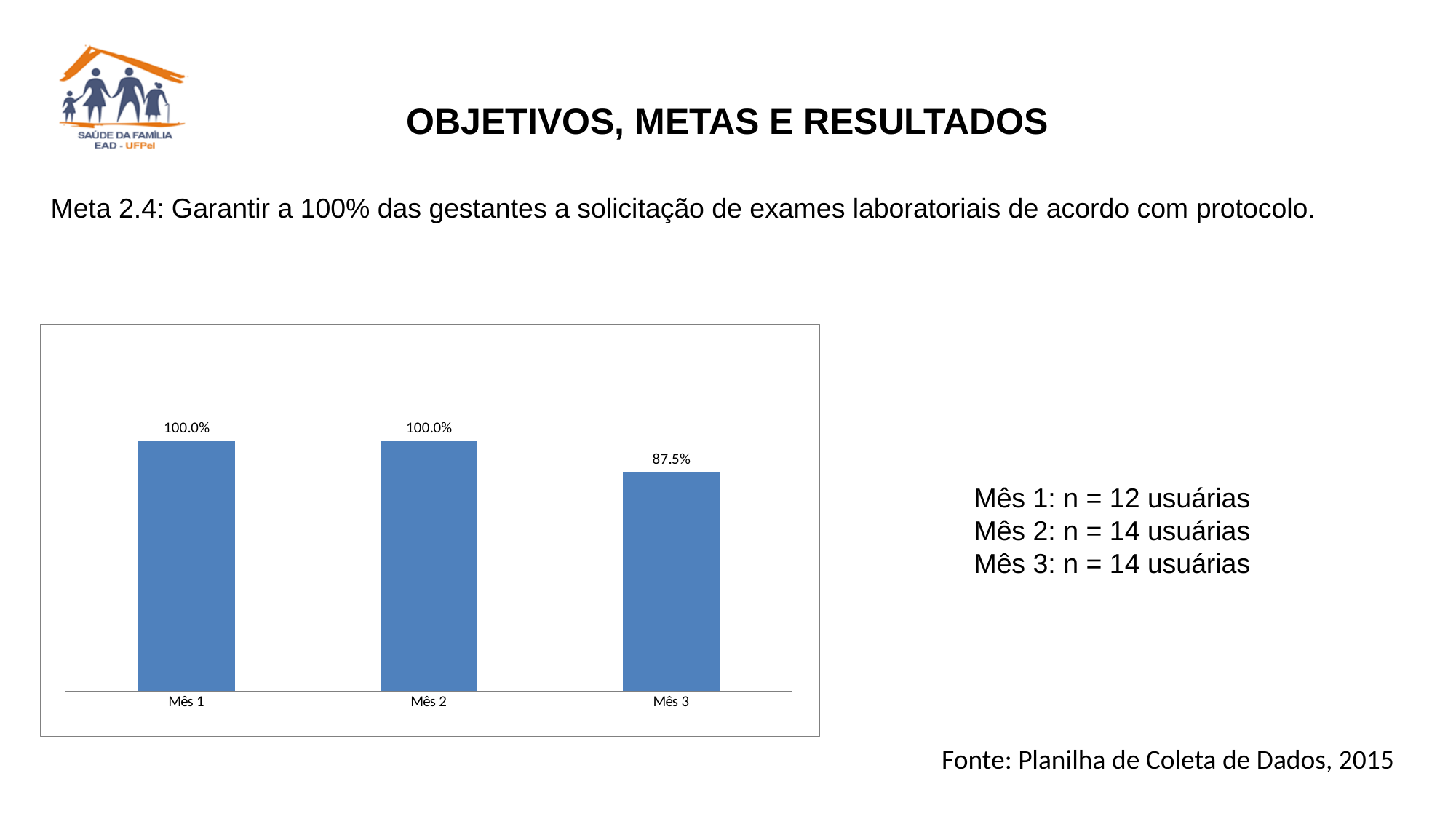
What is the value for Mês 2? 100.0% Do the values rise or fall from Mês 2 to Mês 3? Fall Which month has the lowest value? Mês 3 What is the value for Mês 3? 87.5% What is the label of the third category on the x axis? Mês 3 What kind of chart is shown on the slide? Bar chart Which is larger, the value for Mês 1 or the value for Mês 3? Mês 1 What colour are the bars in the chart? Blue What is the difference between the values for Mês 2 and Mês 3? 12.5% What is the value for Mês 1? 100.0% Do Mês 1 and Mês 2 have the same value? Yes How many categories are shown on the x axis of the chart? 3